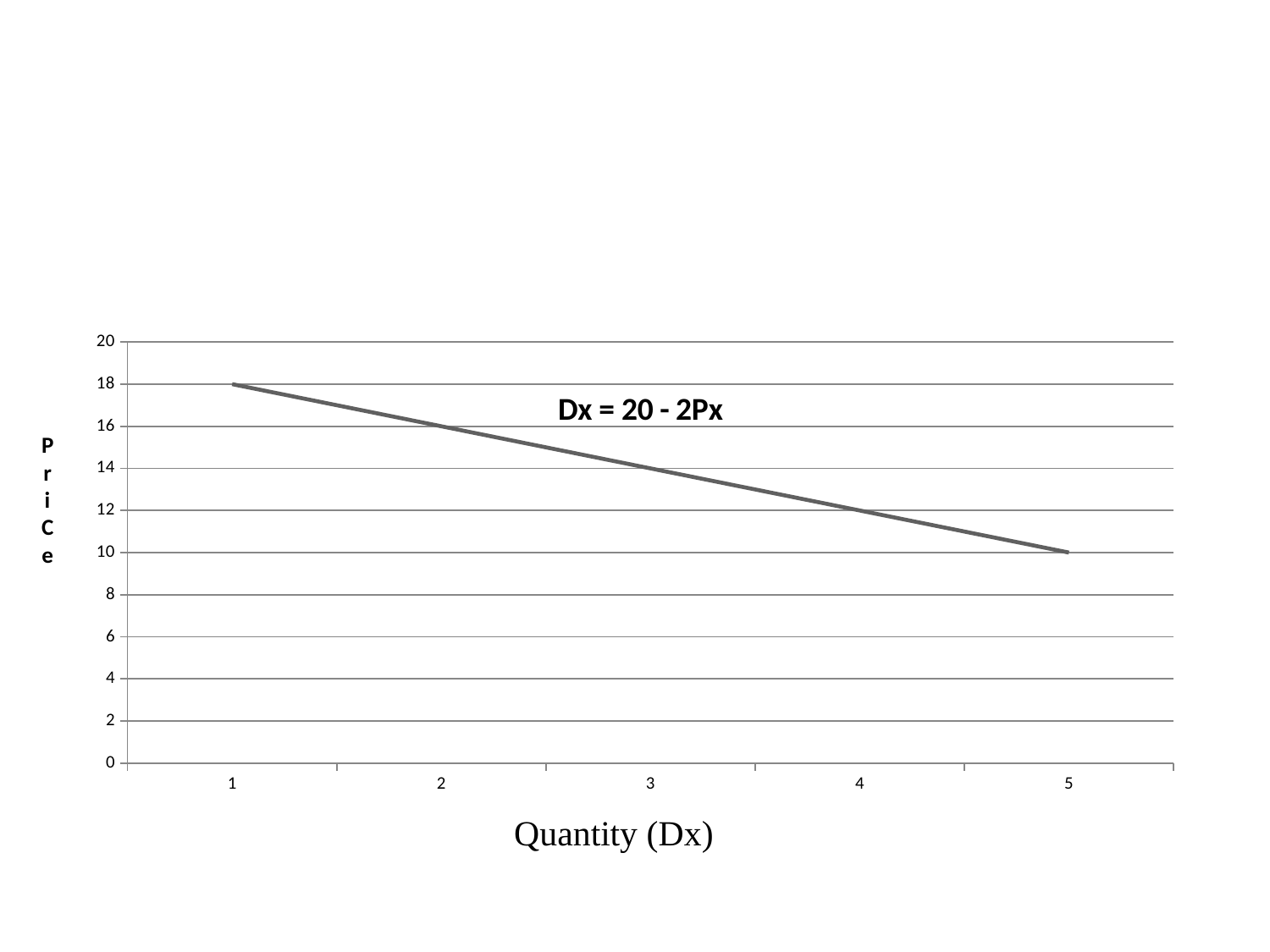
Which is larger, the price at quantity 2 or the price at quantity 4? quantity 2 What is the price value at quantity 5? 10 What is the difference between the price at quantity 1 and the price at quantity 5? 8 What equation is written on the chart next to the line? Dx = 20 - 2Px What kind of chart is shown on the slide? line chart Is the price at quantity 4 greater or less than 14? less At which quantity is the price highest? 1 At which quantity is the price lowest? 5 What is the price value at quantity 1? 18 Do the price values rise or fall as quantity increases along the x axis? fall What is the price value at quantity 3? 14 How many quantity points are plotted along the x axis? 5